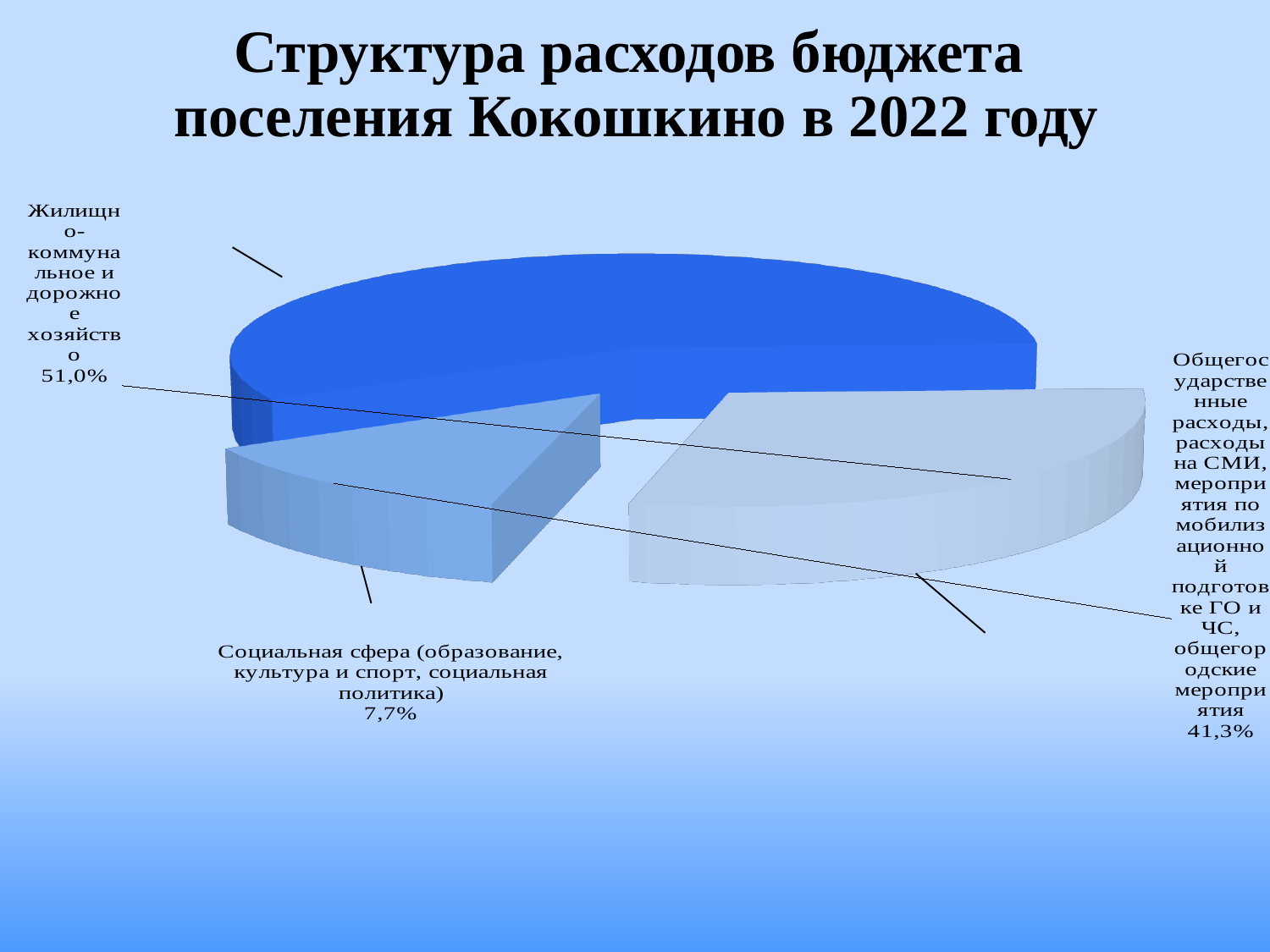
What share of the budget expenses goes to Социальная сфера (образование, культура и спорт, социальная политика)? 7,7% What share of the budget expenses goes to Общегосударственные расходы, расходы на СМИ, мероприятия по мобилизационной подготовке ГО и ЧС, общегородские мероприятия? 41,3% What kind of chart is shown on the slide? Pie chart What is the title of the chart on the slide? Структура расходов бюджета поселения Кокошкино в 2022 году Which category has the smallest share of the budget expenses? Социальная сфера (образование, культура и спорт, социальная политика) Which year does the chart's title refer to? 2022 Which category has the largest share of the budget expenses? Жилищно-коммунальное и дорожное хозяйство How many slices does the pie chart have? 3 What is the difference in percentage points between the share for Общегосударственные расходы and the share for Социальная сфера? 33,6 Which is larger: the share for Социальная сфера or the share for Общегосударственные расходы? Общегосударственные расходы What is the difference in percentage points between the share for Жилищно-коммунальное и дорожное хозяйство and the share for Общегосударственные расходы? 9,7 What share of the budget expenses goes to Жилищно-коммунальное и дорожное хозяйство? 51,0%